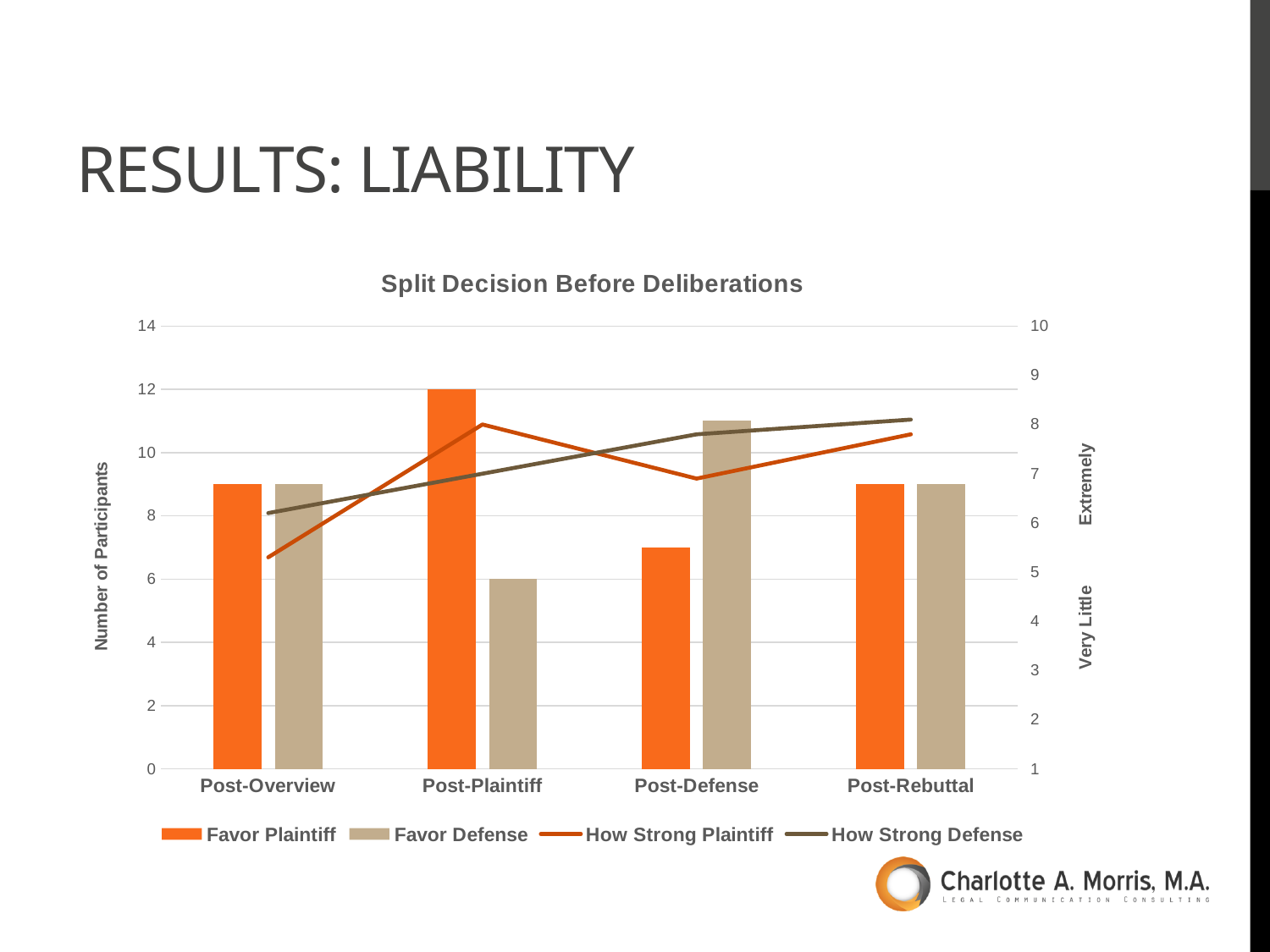
At Post-Plaintiff, what is the difference between the Favor Plaintiff and Favor Defense values? 6 Does the How Strong Defense line rise or fall from Post-Overview to Post-Rebuttal? rise For which category is the Favor Plaintiff bar highest? Post-Plaintiff What kind of chart is shown on the slide? A combination bar and line chart What is the title of the chart? Split Decision Before Deliberations At Post-Defense, which is larger: Favor Plaintiff or Favor Defense? Favor Defense What is the Favor Defense value for Post-Plaintiff? 6 How many series does the legend list? 4 For which category is the Favor Defense bar lowest? Post-Plaintiff How many categories are shown on the x axis? 4 What is the Favor Plaintiff value for Post-Plaintiff? 12 Is the Favor Plaintiff value for Post-Defense greater or less than 8? less